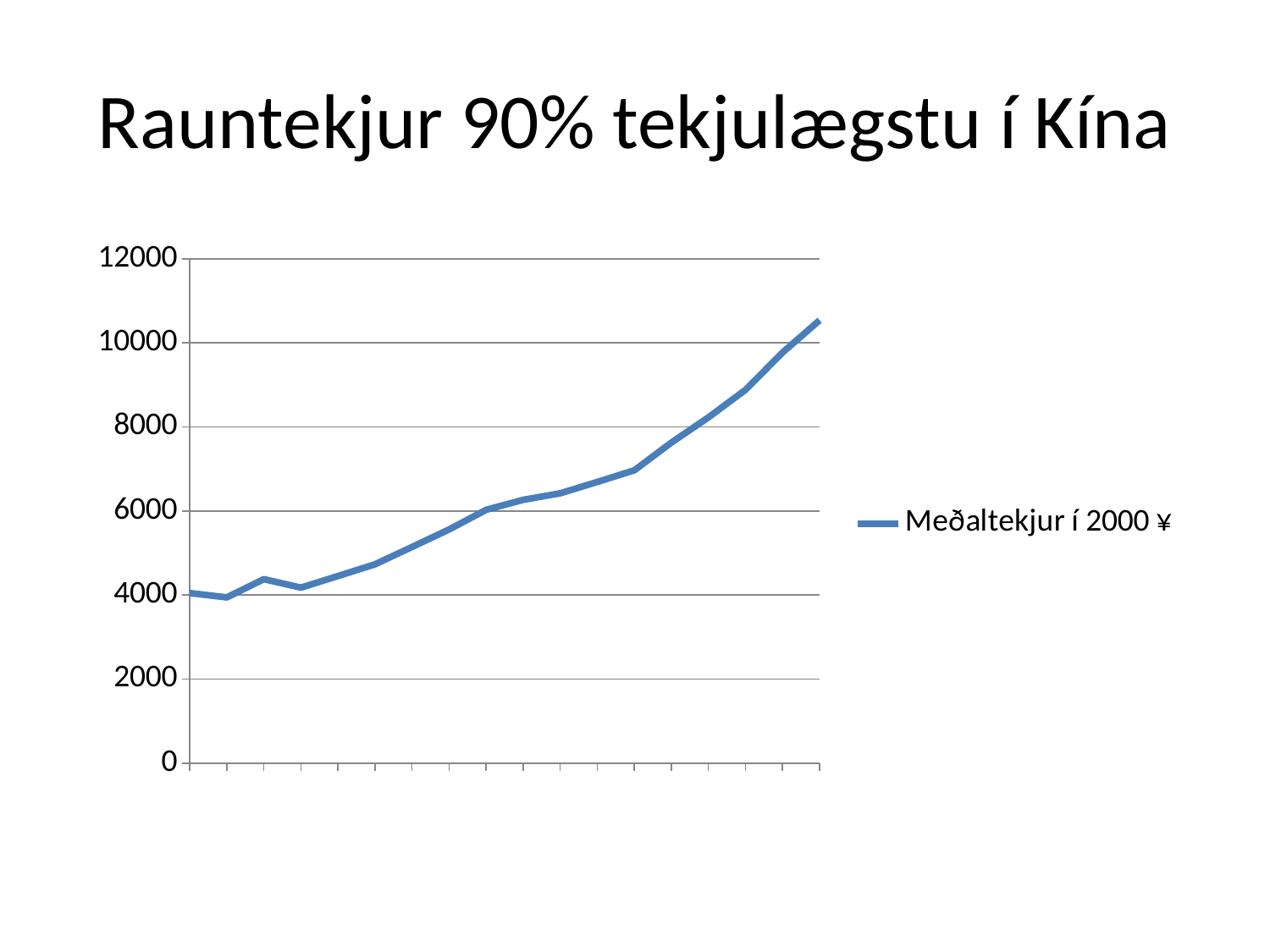
How many series does the legend list? 1 Is the value at the right-hand end of the line greater or less than 10000? greater What is the name of the series shown in the legend? Meðaltekjur í 2000 ¥ What is the title of the chart on the slide? Rauntekjur 90% tekjulægstu í Kína Where along the x axis does the line reach its highest value? at the right-hand end Is the value at the left-hand end of the line greater or less than 6000? less Which end of the line, left or right, has the higher value? right What kind of chart is shown on the slide? line chart What is the highest value shown on the y axis? 12000 Is the value at the left-hand end of the line greater or less than 2000? greater Do the values generally rise or fall from left to right along the x axis? rise